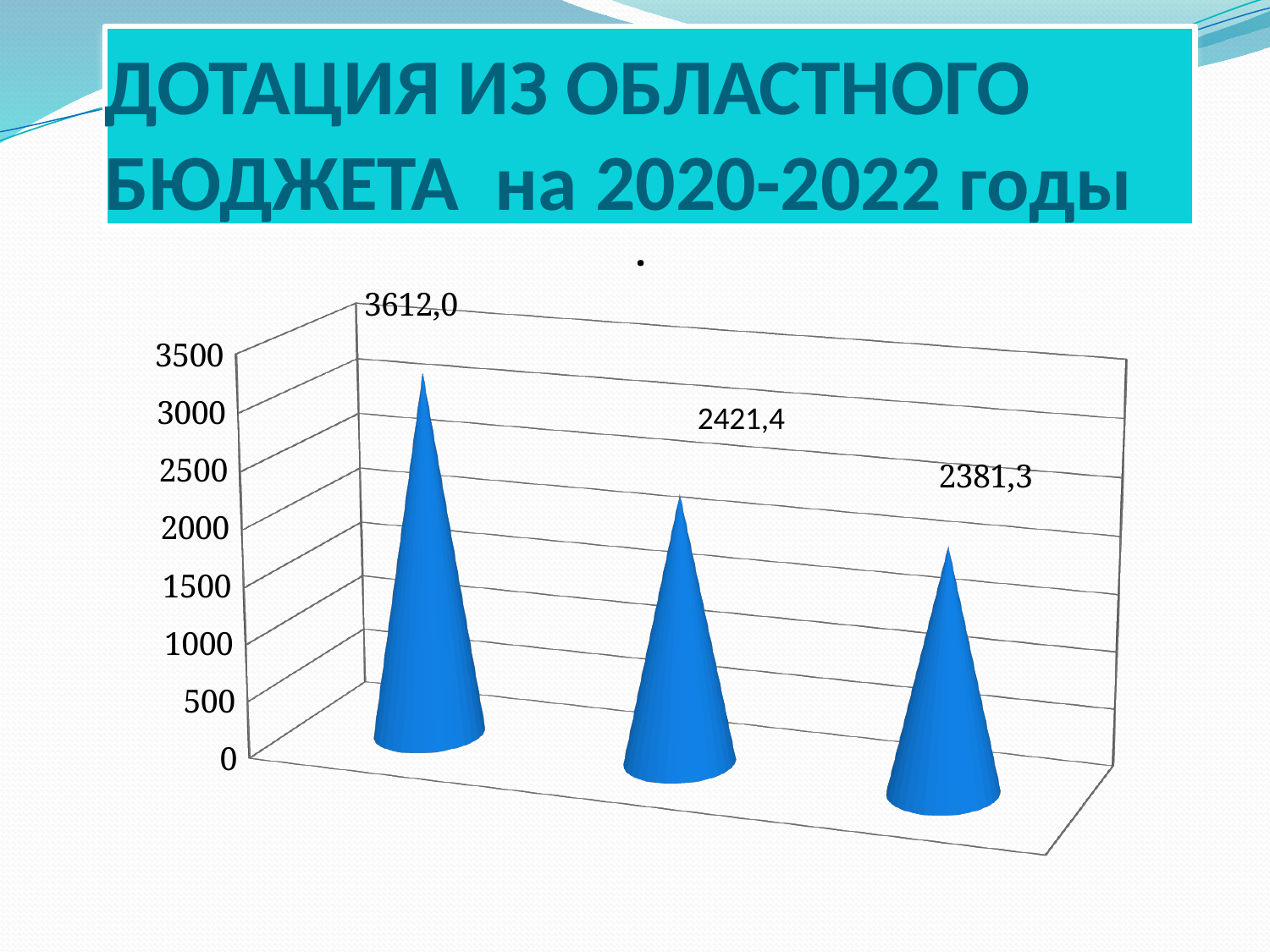
What value is labelled on the middle bar of the chart? 2421,4 Which bar has the lowest value: the leftmost, middle or rightmost? rightmost How many bars are plotted in the chart? 3 What is the difference between the leftmost bar's value and the middle bar's value? 1190,6 What value is labelled on the leftmost bar of the chart? 3612,0 What is the difference between the middle bar's value and the rightmost bar's value? 40,1 Is the value of the middle bar greater or less than 2500? less Do the values rise or fall from left to right across the chart? fall What kind of chart is shown on the slide? bar chart Which is larger, the value of the middle bar or the value of the rightmost bar? the middle bar Which bar has the highest value: the leftmost, middle or rightmost? leftmost What value is labelled on the rightmost bar of the chart? 2381,3